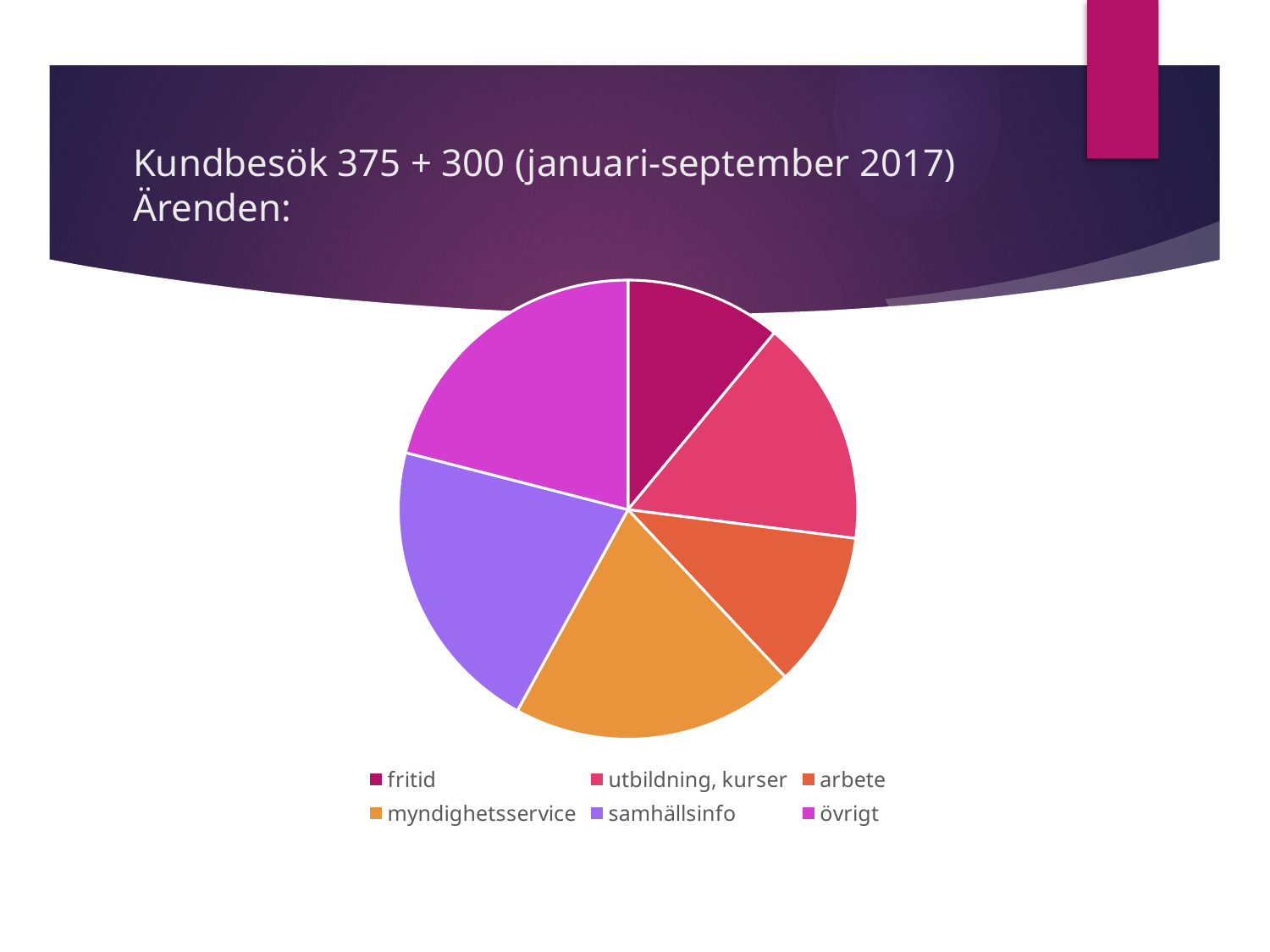
Which slice is larger, myndighetsservice or utbildning, kurser? myndighetsservice Which slice is larger, samhällsinfo or arbete? samhällsinfo What kind of chart is shown on the slide? pie chart Which legend entry is shown in orange? myndighetsservice Which slice is larger, utbildning, kurser or fritid? utbildning, kurser How many entries does the legend of the pie chart list? 6 What is the title text shown above the pie chart? Kundbesök 375 + 300 (januari-september 2017) Ärenden: How many categories (slices) does the pie chart have? 6